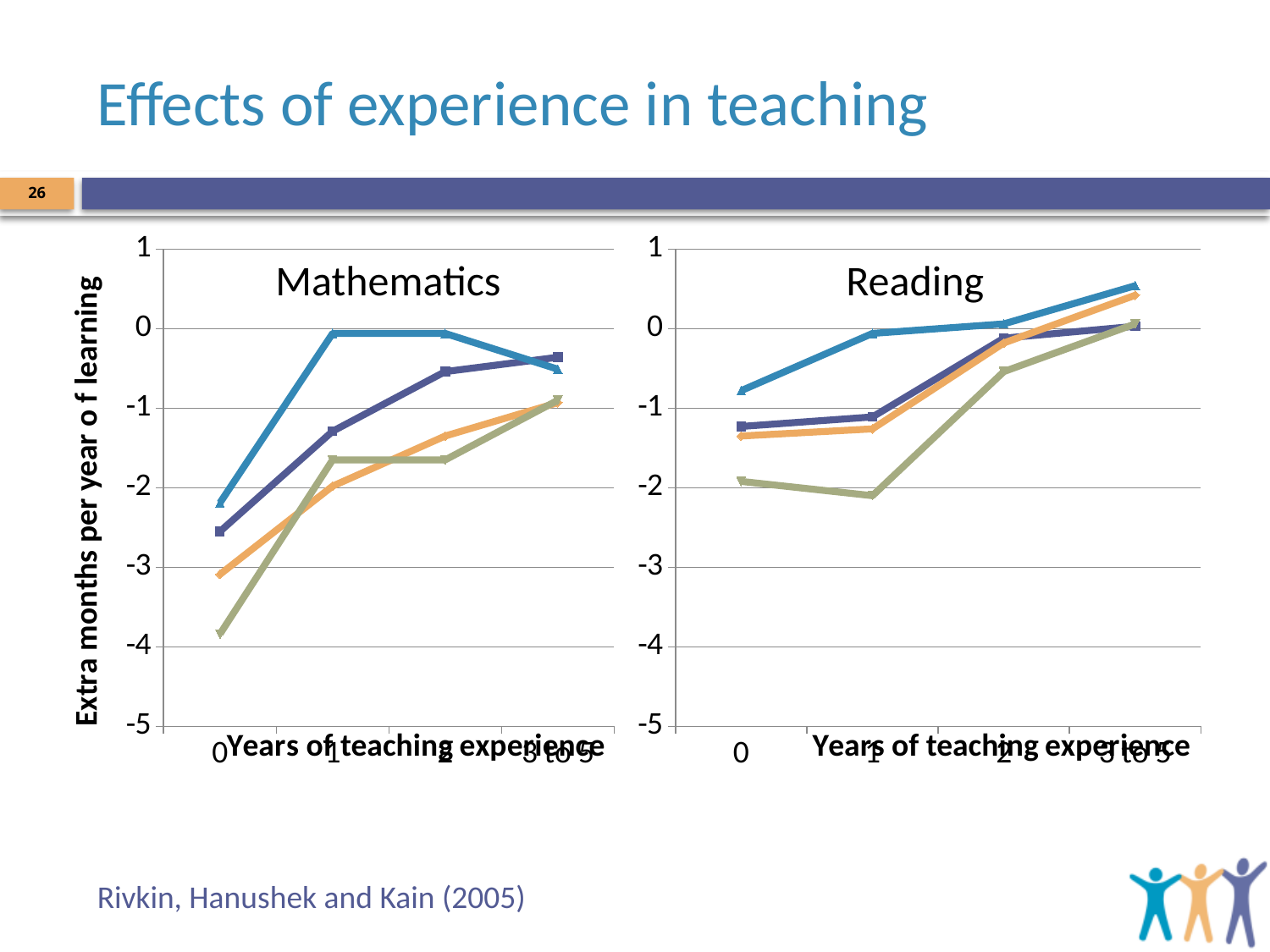
In the Mathematics chart, is the value of the green line at 0 years greater or less than -3? less In the Mathematics chart, which line is lowest at 0 years of experience? the green line In the Reading chart, at 0 years of experience, which is higher: the light blue line or the green line? the light blue line In the Reading chart, do the values generally rise or fall as years of teaching experience increase? rise In the Mathematics chart, is the value of the light blue line at 0 years greater or less than -2? less In the Reading chart, is the value of the orange line at 3 to 5 years greater or less than 0? greater What is the label of the y axis on the left chart? Extra months per year of learning In the Mathematics chart, do the values generally rise or fall as years of teaching experience increase? rise What is the label of the x axis on the Reading chart? Years of teaching experience How many points are on the x axis of the Reading chart? 4 What type of chart is the Mathematics chart? line chart